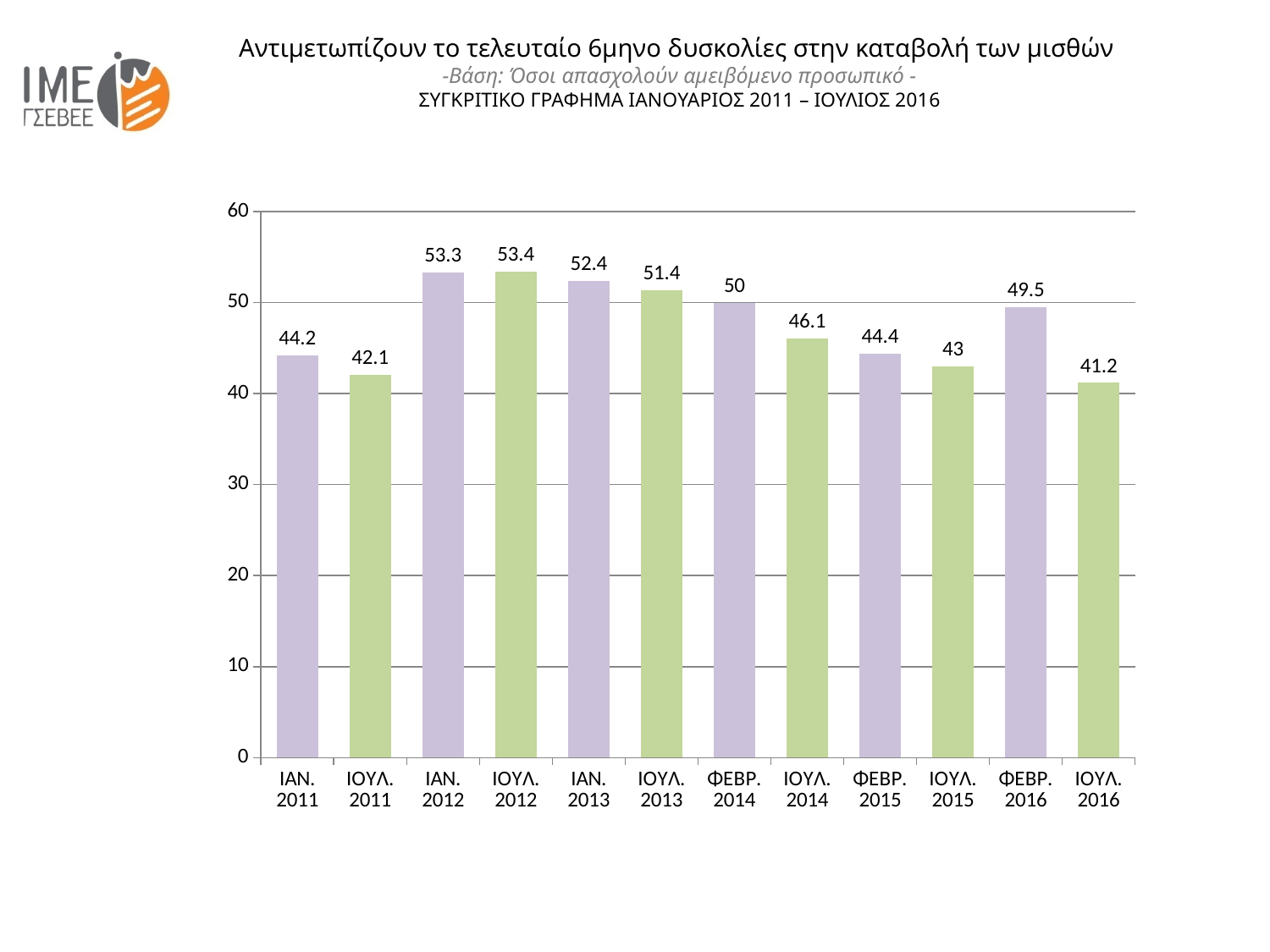
Which is larger, the value for ΙΑΝ. 2013 or the value for ΙΟΥΛ. 2013? ΙΑΝ. 2013 Which period has the highest value? ΙΟΥΛ. 2012 What is the value for ΙΟΥΛ. 2016? 41.2 What is the value for ΦΕΒΡ. 2014? 50 Do the values rise or fall from ΦΕΒΡ. 2014 to ΙΟΥΛ. 2015? fall What is the value for ΙΑΝ. 2011? 44.2 What kind of chart is shown on the slide? bar chart Is the value for ΙΟΥΛ. 2015 greater or less than 50? less Which period has the lowest value? ΙΟΥΛ. 2016 How many periods are shown on the x axis? 12 What is the difference between the values for ΙΑΝ. 2012 and ΙΟΥΛ. 2011? 11.2 What is the difference between the values for ΦΕΒΡ. 2016 and ΙΟΥΛ. 2016? 8.3